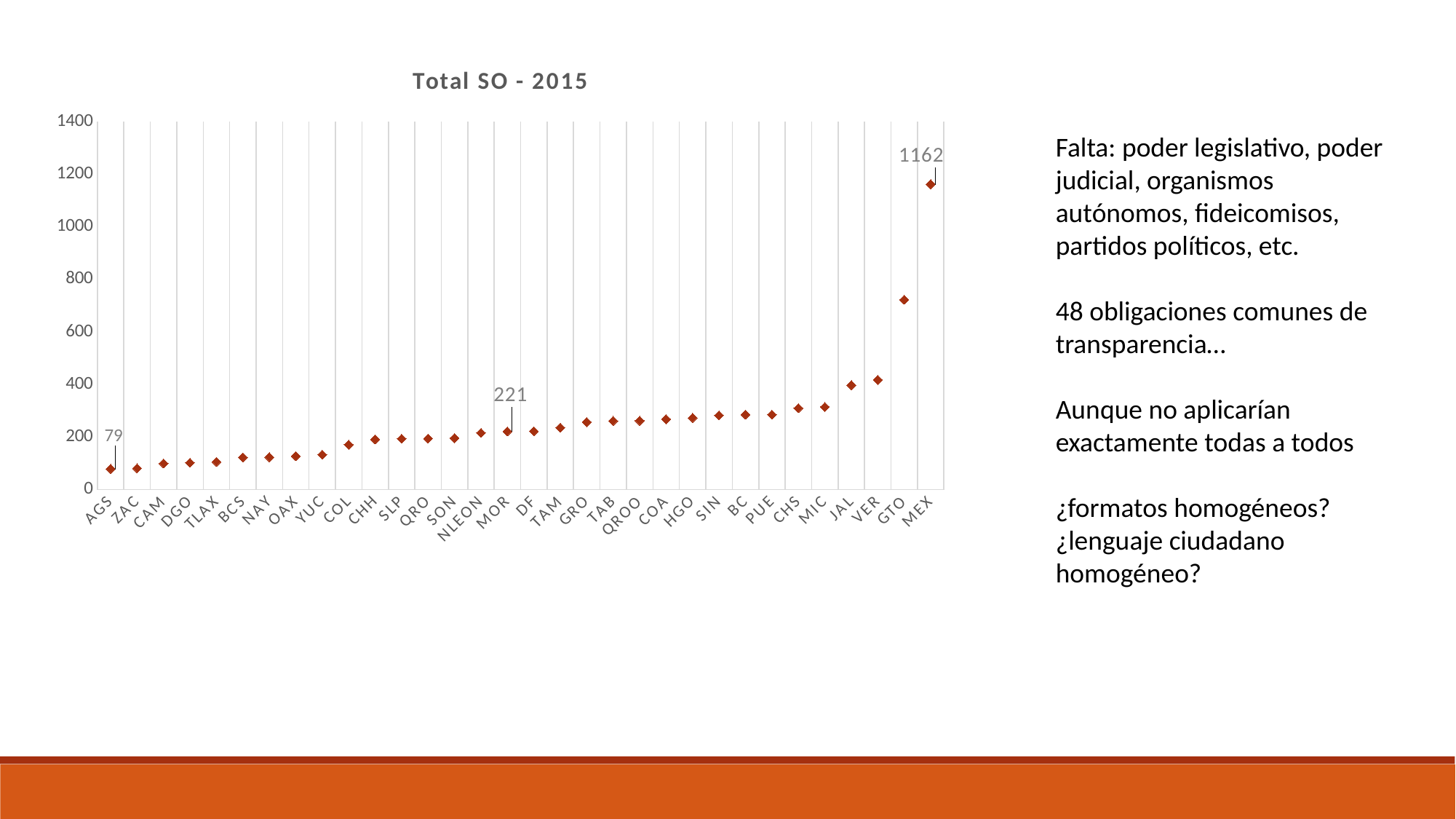
What is the value for MOR in the Total SO - 2015 chart? 221 Is the value for CHS greater or less than 200? greater Do the values rise or fall from left to right along the x axis? rise What is the difference between the values for MEX and AGS? 1083 Is the value for GTO greater or less than 600? greater How many categories are plotted along the x axis? 32 What is the value for MEX in the Total SO - 2015 chart? 1162 What is the value for AGS in the Total SO - 2015 chart? 79 What is the difference between the values for MOR and AGS? 142 Which has a larger value, GTO or VER? GTO Which category has the highest value in the Total SO - 2015 chart? MEX What is the title of the chart? Total SO - 2015